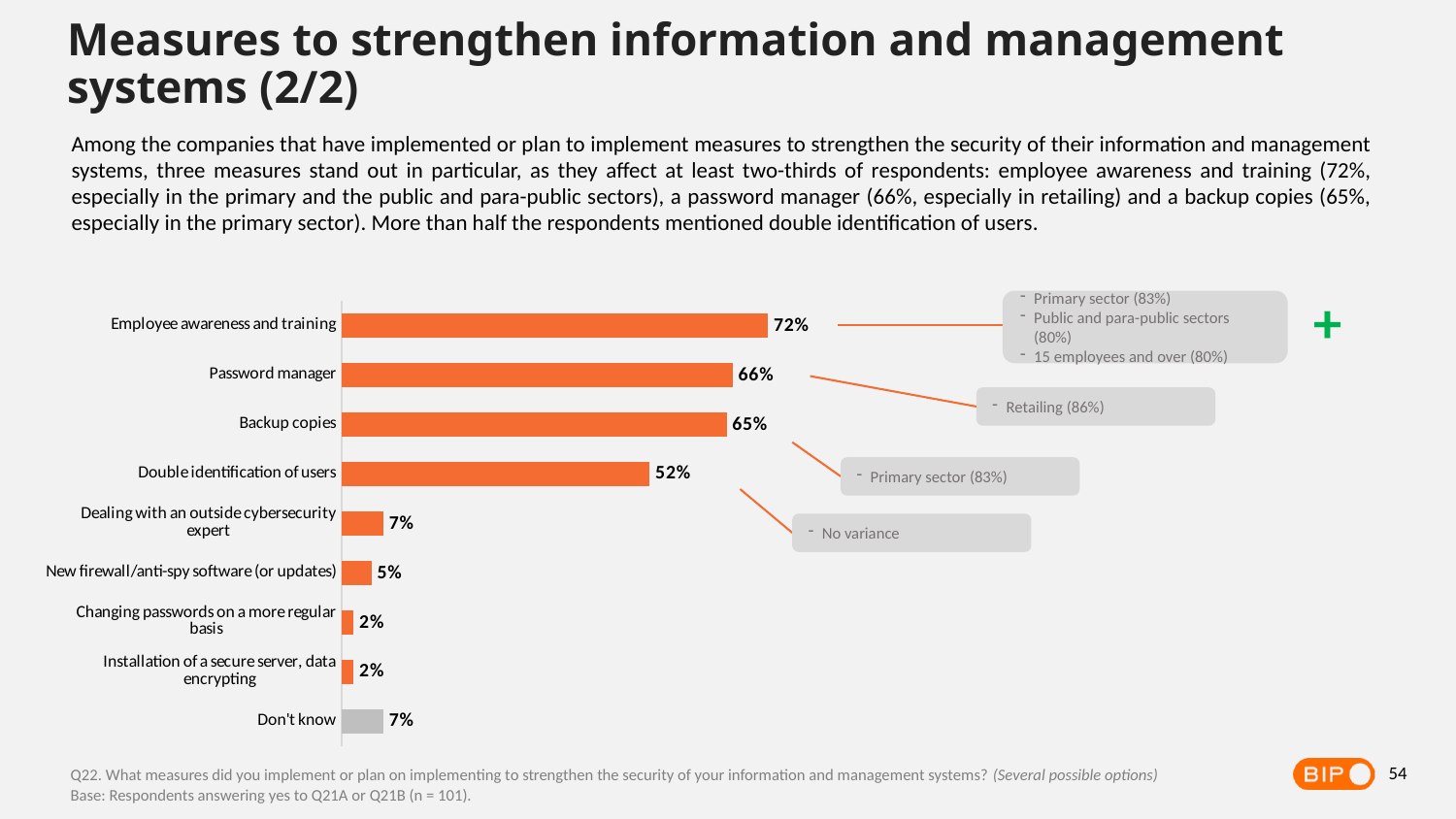
Which is larger, the value for Backup copies or the value for Double identification of users? Backup copies What is the value shown for New firewall/anti-spy software (or updates)? 5% What is the value shown for Don't know? 7% Which bar is shown in a different colour (grey) from the others? Don't know What kind of chart is shown on the slide? Bar chart How many categories are shown in the chart? 9 What is the value shown for Password manager? 66% What percentage of respondents mentioned employee awareness and training? 72% What is the value shown for Double identification of users? 52% Which measure has the highest percentage? Employee awareness and training What is the difference between the values for Employee awareness and training and Double identification of users? 20% What is the difference between the values for Password manager and Backup copies? 1%